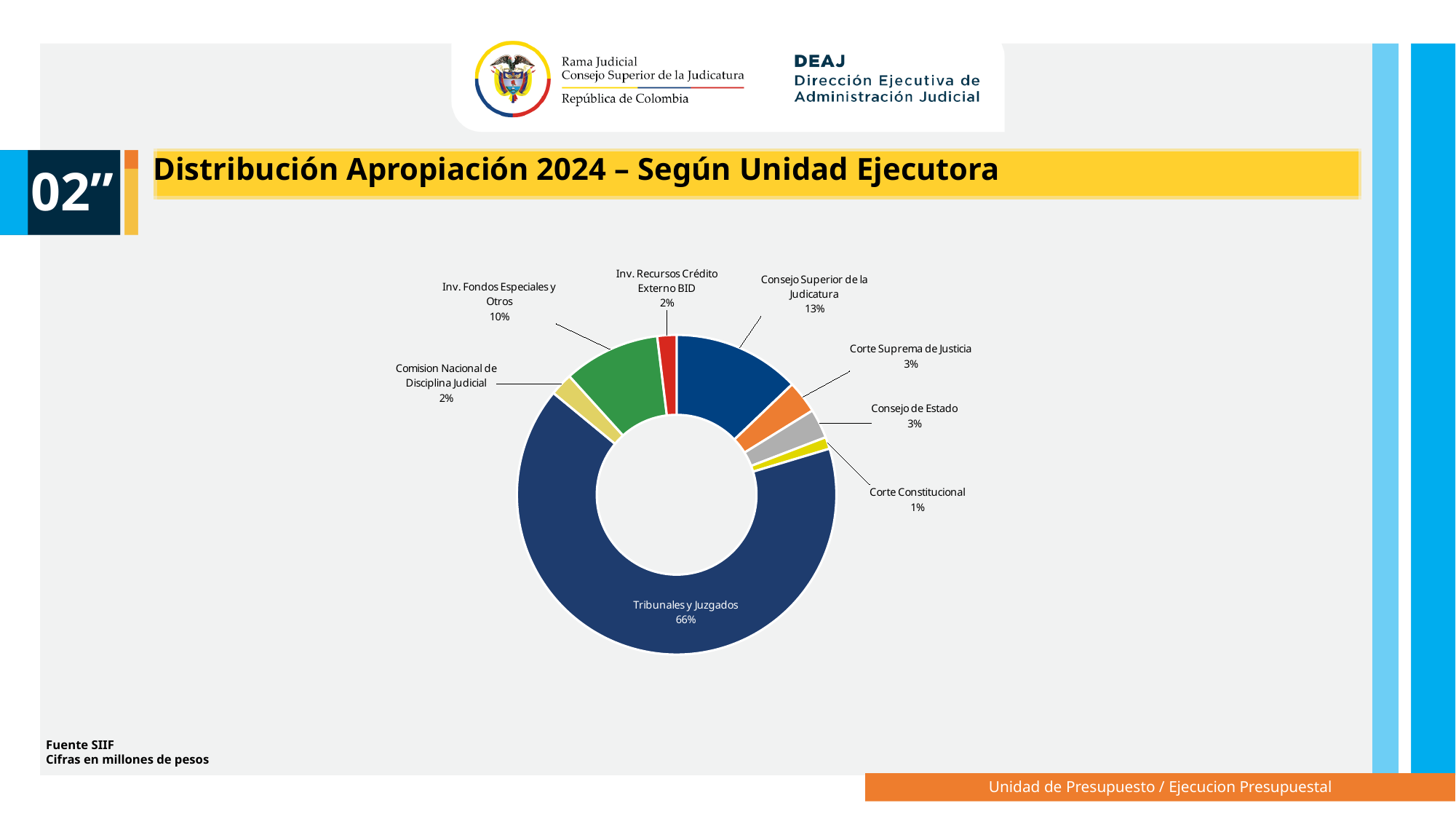
What is the difference in percentage points between Tribunales y Juzgados and Consejo Superior de la Judicatura? 53 Which category has the largest share of the pie? Tribunales y Juzgados What percentage is shown for Consejo Superior de la Judicatura? 13% What kind of chart is shown on the slide? Doughnut chart What share of the pie does Tribunales y Juzgados represent? 66% Which category has the smallest share of the pie? Corte Constitucional What percentage is shown for Corte Constitucional? 1% What is the title of the slide containing the chart? Distribución Apropiación 2024 – Según Unidad Ejecutora Which has a larger share, Inv. Fondos Especiales y Otros or Consejo de Estado? Inv. Fondos Especiales y Otros What percentage is shown for Corte Suprema de Justicia? 3% How many categories are shown in the chart? 8 What percentage is shown for Inv. Fondos Especiales y Otros? 10%